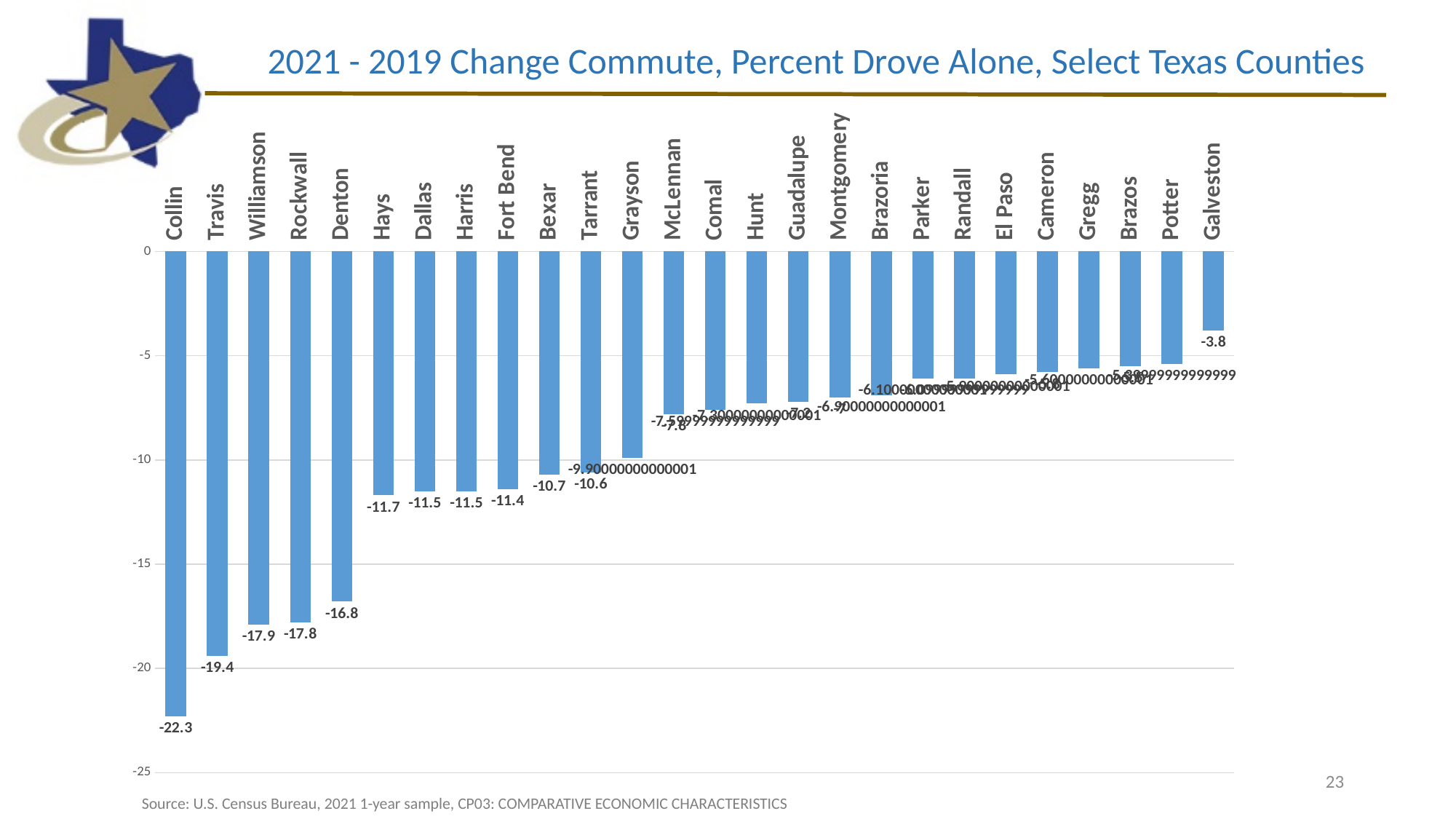
How many counties are shown in the chart? 26 Which county has the lowest (most negative) value? Collin Which has the larger decline, Denton or Hays? Denton Which county has the highest (least negative) value? Galveston What is the value for Collin? -22.3 What is the difference between the values for Collin and Travis? 2.9 What is the value for Bexar? -10.7 Is the value for Montgomery greater or less than -5? less What is the value for Galveston? -3.8 What kind of chart is shown on the slide? Bar chart What is the value for Travis? -19.4 What is the value for Denton? -16.8